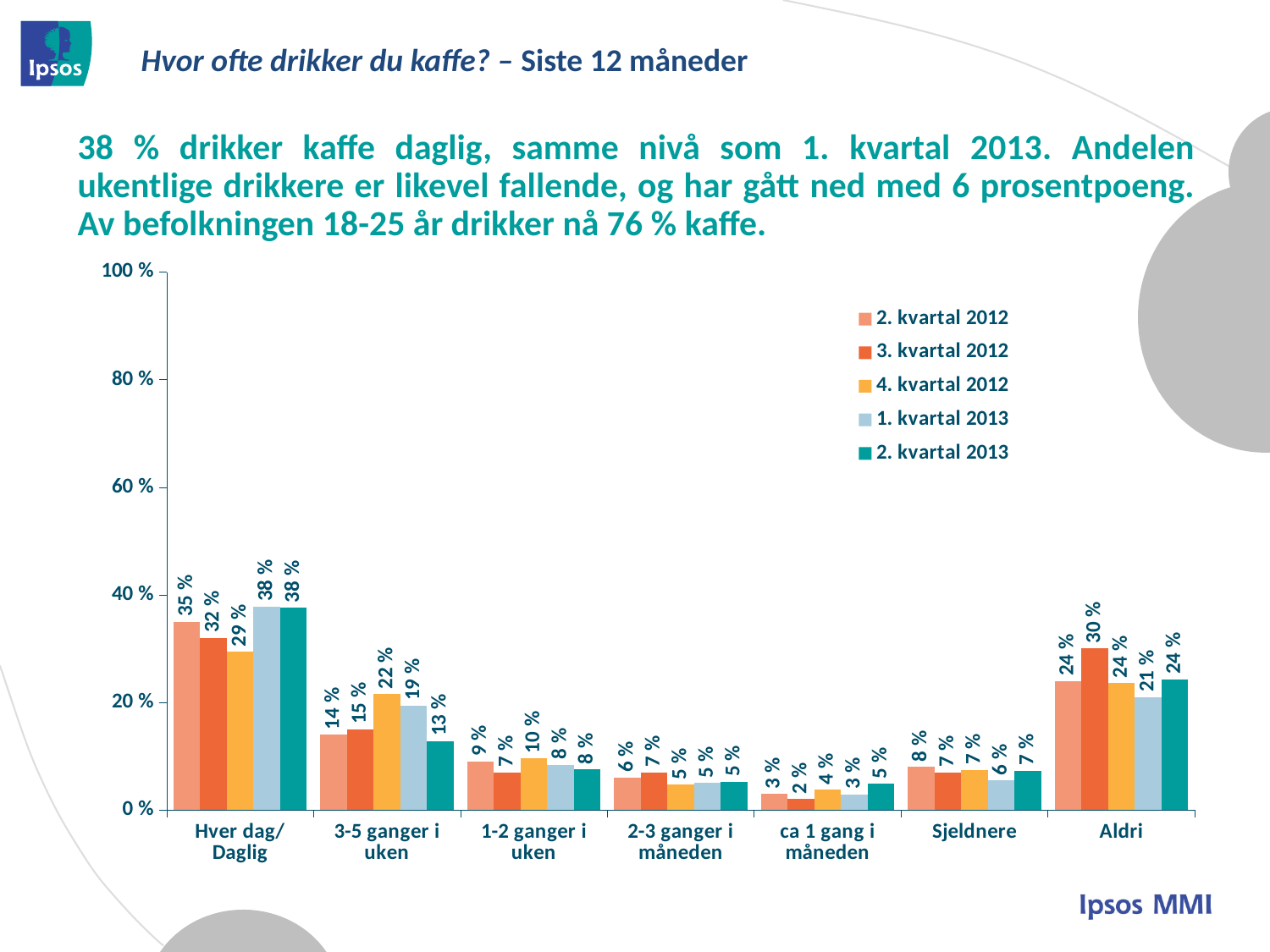
What is the value for "3-5 ganger i uken" in the 4. kvartal 2012 series? 22 % Which series is shown in the darkest teal colour in the legend? 2. kvartal 2013 Which category has the highest value in the 2. kvartal 2013 series? Hver dag/ Daglig What is the value for "Aldri" in the 3. kvartal 2012 series? 30 % How many categories are shown on the x axis? 7 How many series does the legend list? 5 For "Aldri", which is larger: the 3. kvartal 2012 value or the 1. kvartal 2013 value? 3. kvartal 2012 What is the value for "Hver dag/ Daglig" in the 2. kvartal 2013 series? 38 % What is the difference between the 2. kvartal 2012 and 2. kvartal 2013 values for "3-5 ganger i uken"? 1 % What kind of chart is shown on the slide? Bar chart Which category has the lowest value in the 2. kvartal 2012 series? ca 1 gang i måneden What is the value for "ca 1 gang i måneden" in the 3. kvartal 2012 series? 2 %